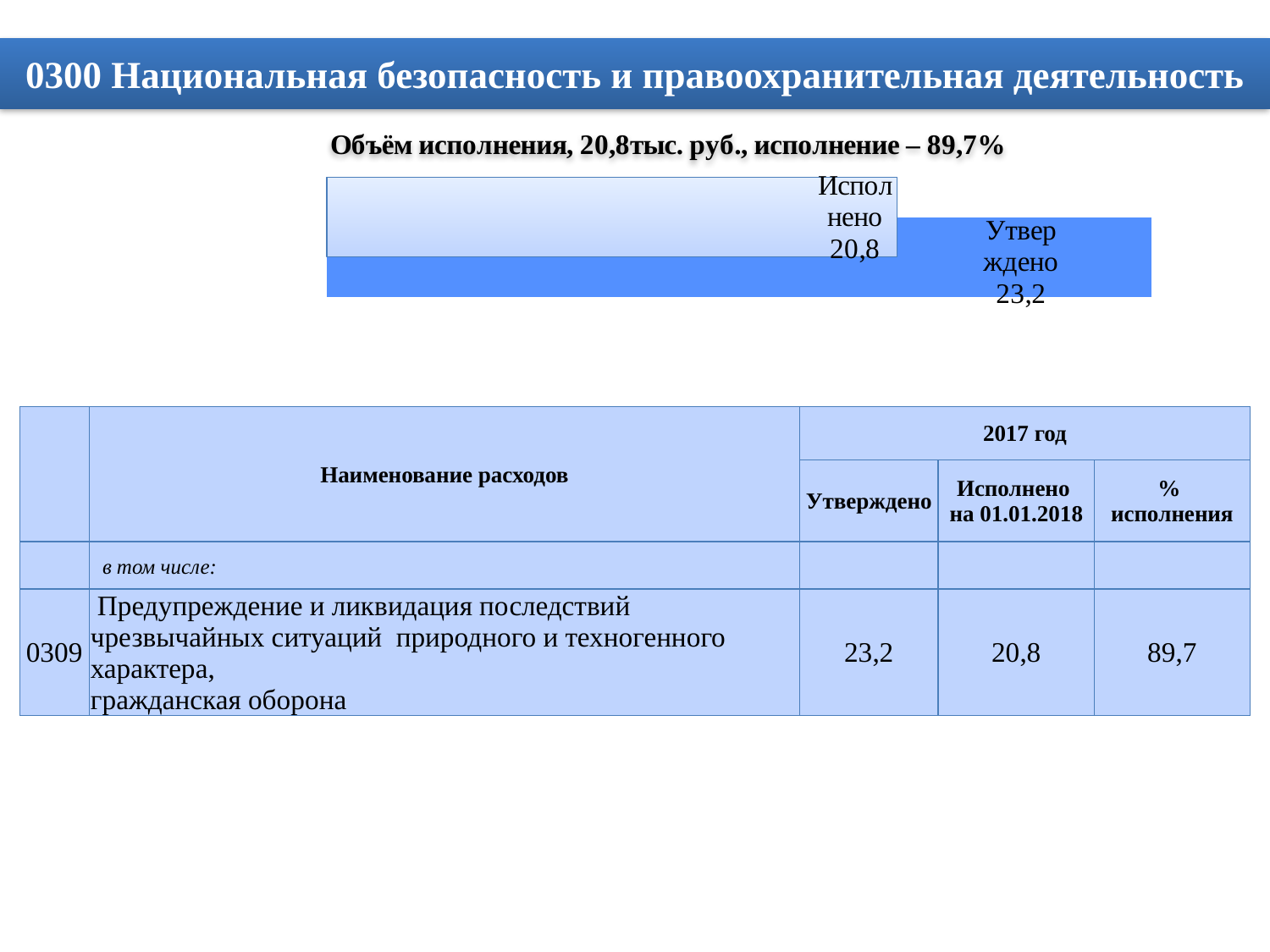
What heading is printed above the chart? Объём исполнения, 20,8тыс. руб., исполнение – 89,7% How many bars does the chart show? 2 What is the difference between the Утверждено and Исполнено values? 2,4 Which is larger, Утверждено or Исполнено? Утверждено Which bar has the highest value? Утверждено Which bar has the lowest value? Исполнено What is the value of the bar labelled Исполнено? 20,8 What is the value of the bar labelled Утверждено? 23,2 What kind of chart is shown on the slide? bar chart What colour is the Утверждено bar? blue